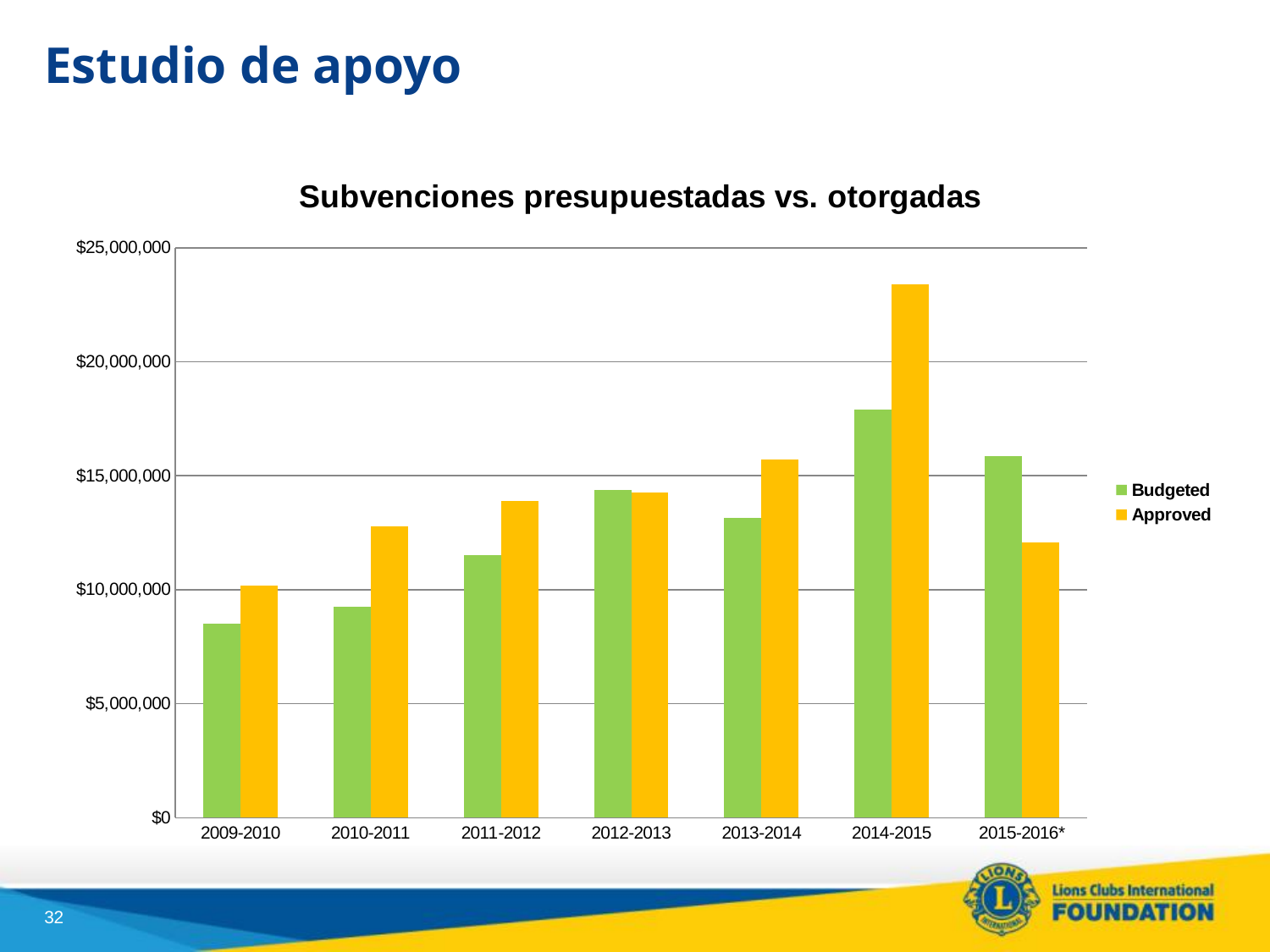
Which year has the lowest Budgeted value? 2009-2010 What is the title of the chart? Subvenciones presupuestadas vs. otorgadas Is the Budgeted value for 2009-2010 greater or less than $10,000,000? less For 2013-2014, which is larger, Budgeted or Approved? Approved Is the Budgeted value for 2014-2015 greater or less than $15,000,000? greater Is the Approved value for 2014-2015 greater or less than $20,000,000? greater What kind of chart is shown on the slide? Bar chart How many fiscal-year categories are shown on the x axis? 7 How many series does the legend list? 2 Which year has the highest Budgeted value? 2014-2015 Which year has the highest Approved value? 2014-2015 For 2015-2016*, which is larger, Budgeted or Approved? Budgeted